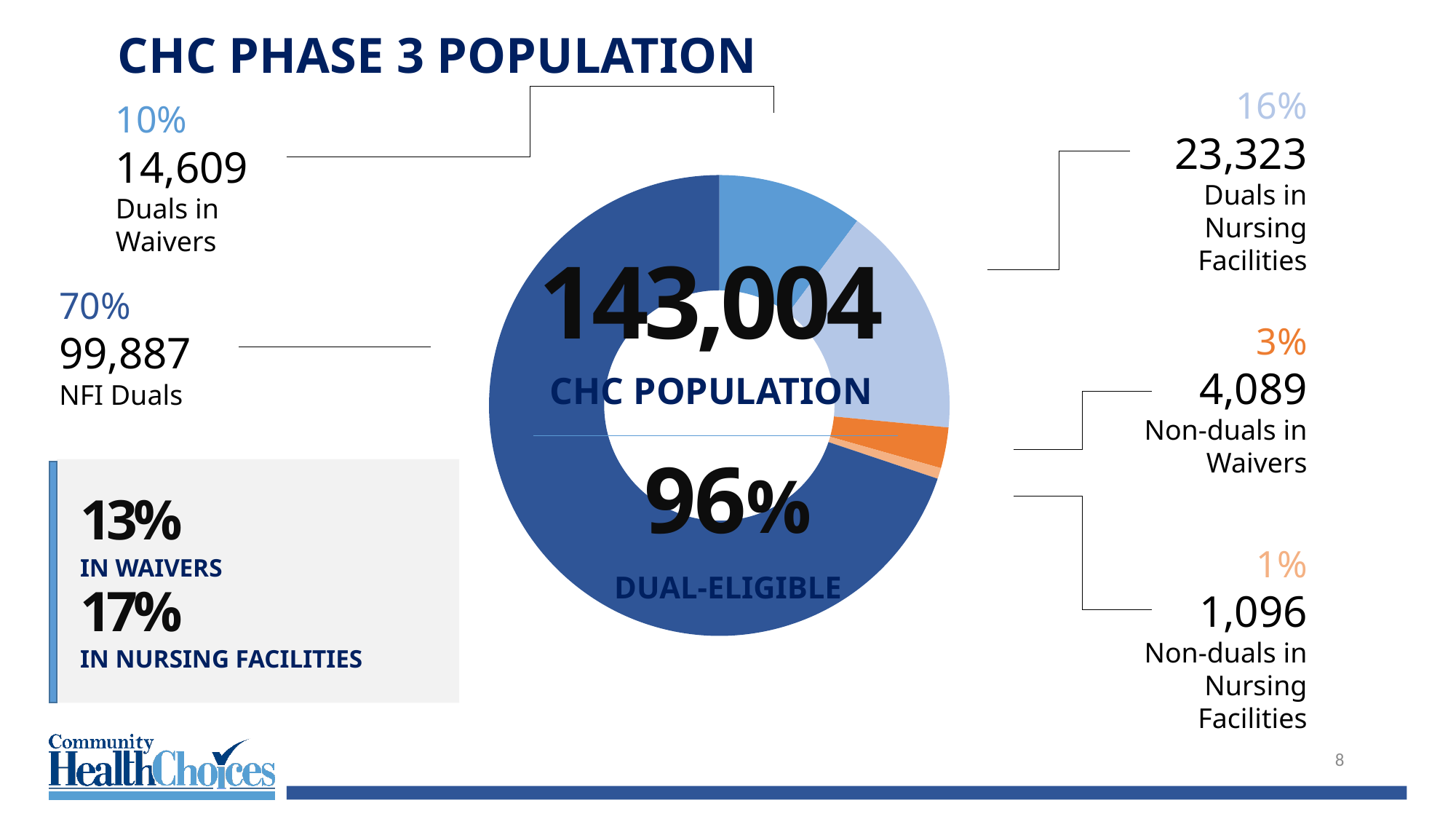
Which category has the largest share of the CHC population? NFI Duals How many categories are shown in the chart? 5 Which category has the smallest share of the CHC population? Non-duals in Nursing Facilities Which is larger, Non-duals in Waivers or Non-duals in Nursing Facilities? Non-duals in Waivers What is the value for NFI Duals? 99,887 What is the difference between Duals in Nursing Facilities and Duals in Waivers? 8,714 What is the value for Non-duals in Waivers? 4,089 What is the value for Duals in Nursing Facilities? 23,323 What percentage share does Non-duals in Nursing Facilities represent? 1% What kind of chart is shown on the slide? Donut (pie) chart What total CHC population is shown in the centre of the chart? 143,004 What percentage share does Duals in Waivers represent? 10%